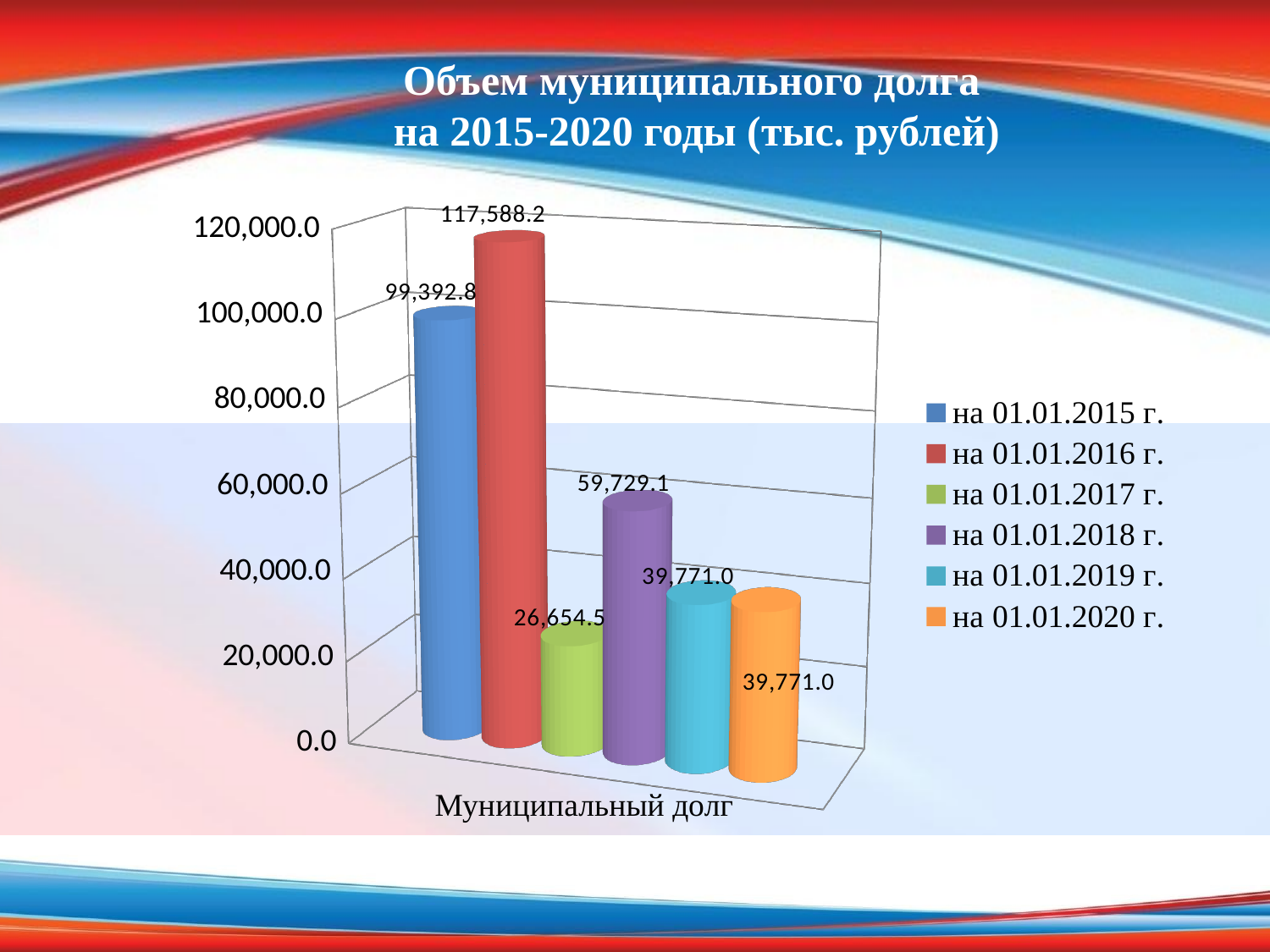
How many series does the legend list? 6 What is the value for на 01.01.2018 г.? 59,729.1 Which is larger, the value for на 01.01.2018 г. or the value for на 01.01.2019 г.? на 01.01.2018 г. What is the value for на 01.01.2017 г.? 26,654.5 What is the category label shown on the x axis? Муниципальный долг What is the value for на 01.01.2015 г.? 99,392.8 What is the difference between the values for на 01.01.2016 г. and на 01.01.2015 г.? 18,195.4 What is the title of the chart? Объем муниципального долга на 2015-2020 годы (тыс. рублей) What is the value for на 01.01.2016 г.? 117,588.2 What kind of chart is shown on the slide? bar chart Which series has the lowest value? на 01.01.2017 г. Which series has the highest value? на 01.01.2016 г.